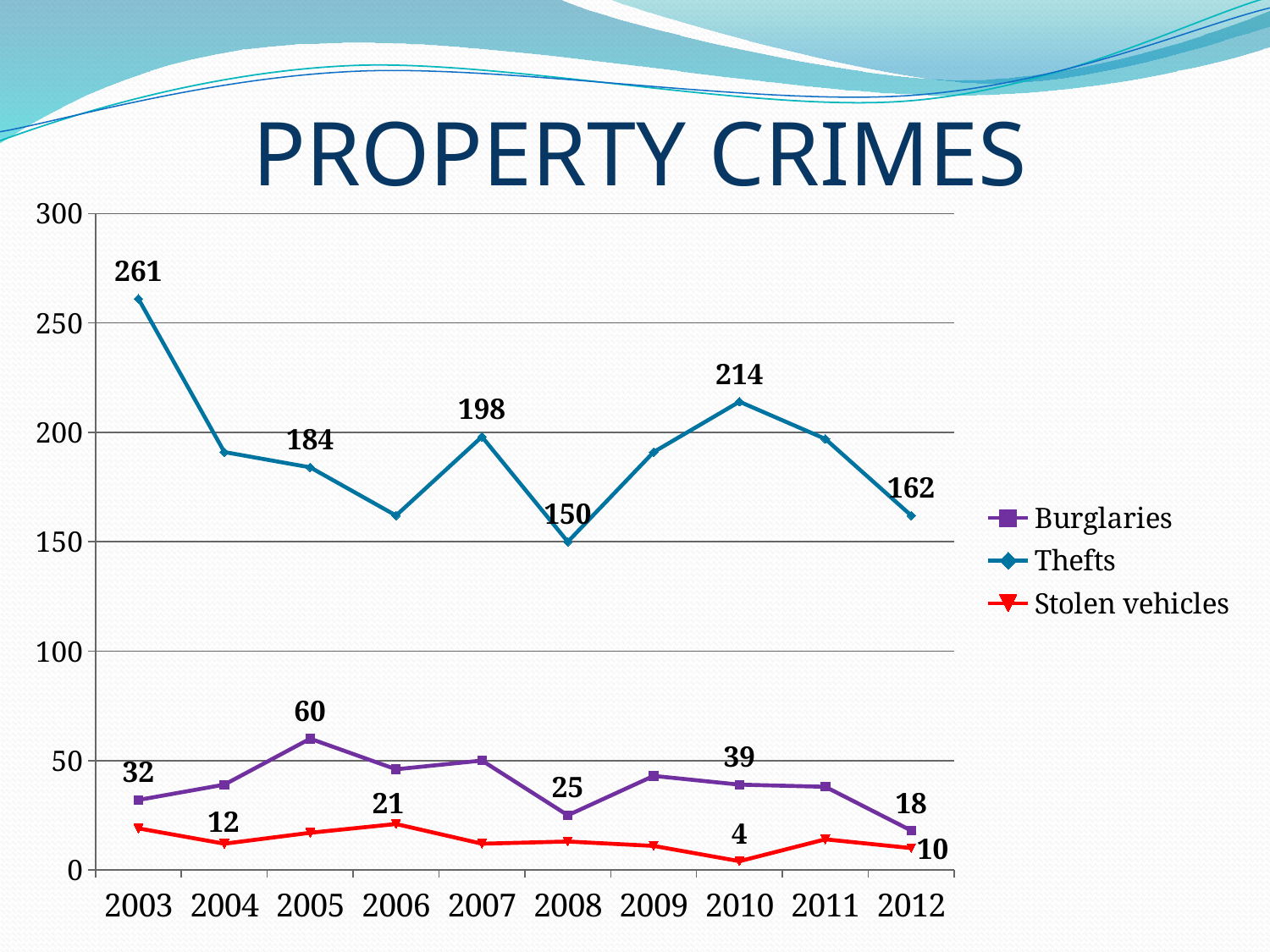
What kind of chart is shown on the slide? line chart What is the difference between the Thefts values in 2003 and 2012? 99 In which year is the Thefts value highest? 2003 What is the value for Burglaries in 2005? 60 In which year is the Thefts value lowest? 2008 How many years are shown on the x axis? 10 Is the value for Thefts in 2009 greater or less than 150? greater Which is larger, the Burglaries value in 2005 or the Burglaries value in 2012? 2005 What is the value for Thefts in 2003? 261 What is the value for Stolen vehicles in 2010? 4 How many series does the legend list? 3 Does the Thefts value rise or fall from 2003 to 2004? fall